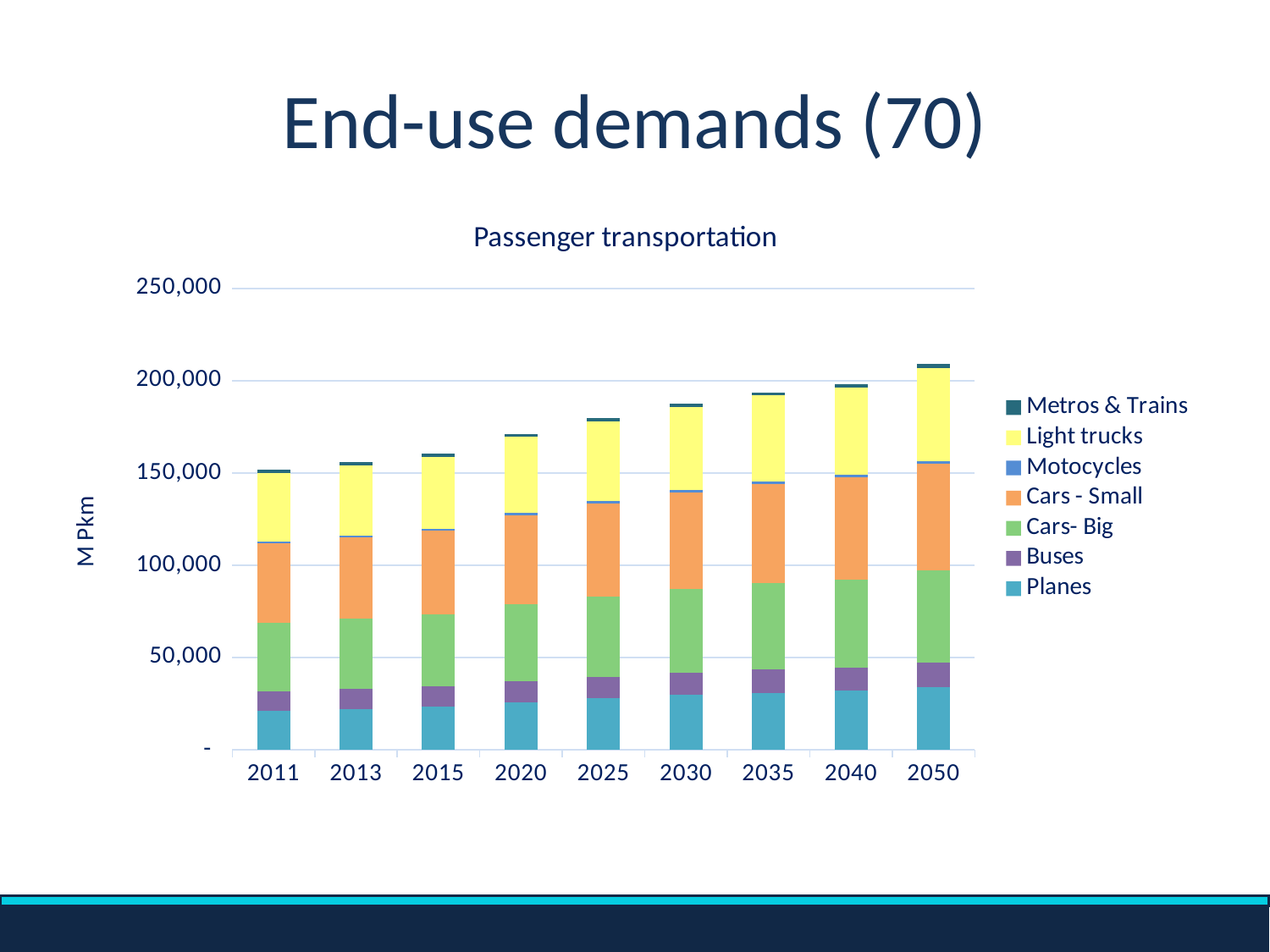
What kind of chart is shown on the slide? stacked bar chart Is the total value for 2050 greater or less than 200,000? greater What is the title of the chart? Passenger transportation How many series does the legend list? 7 Which year has the lowest total passenger transportation demand? 2011 Which year has the highest total passenger transportation demand? 2050 Is the total value for 2020 greater or less than 150,000? greater Do the total bar heights rise or fall from 2011 to 2050? rise What is the label on the vertical axis of the chart? M Pkm How many years are shown along the x axis? 9 Is the total value for 2030 greater or less than 200,000? less Is the total value for 2050 larger or smaller than the total value for 2011? larger